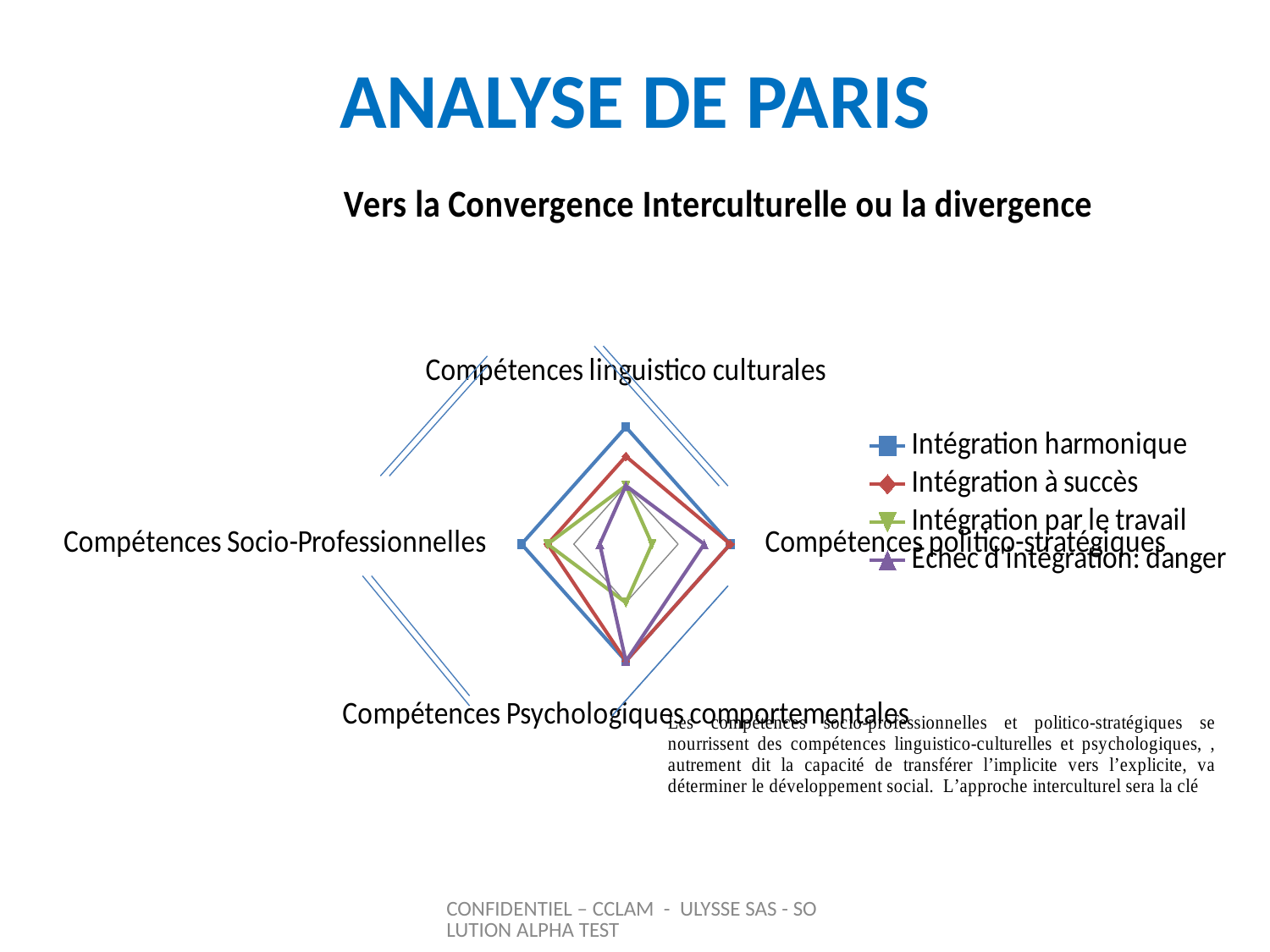
Which series is drawn in green on the radar chart? Intégration par le travail How many axes (categories) does the radar chart have? 4 Which series is drawn in purple on the radar chart? Échec d'intégration: danger On the Compétences Socio-Professionnelles axis, which series has the highest value? Intégration harmonique What kind of chart is shown on the slide? radar chart On the Compétences politico-stratégiques axis, which is larger: Intégration harmonique or Intégration par le travail? Intégration harmonique On the Compétences politico-stratégiques axis, which series has the lowest value? Intégration par le travail On the Compétences Psychologiques comportementales axis, which is larger: Intégration à succès or Intégration par le travail? Intégration à succès On the Compétences Socio-Professionnelles axis, which series has the lowest value? Échec d'intégration: danger How many series does the legend of the radar chart list? 4 On the Compétences Socio-Professionnelles axis, which is larger: Intégration harmonique or Échec d'intégration: danger? Intégration harmonique On the Compétences linguistico culturales axis, which series has the highest value? Intégration harmonique